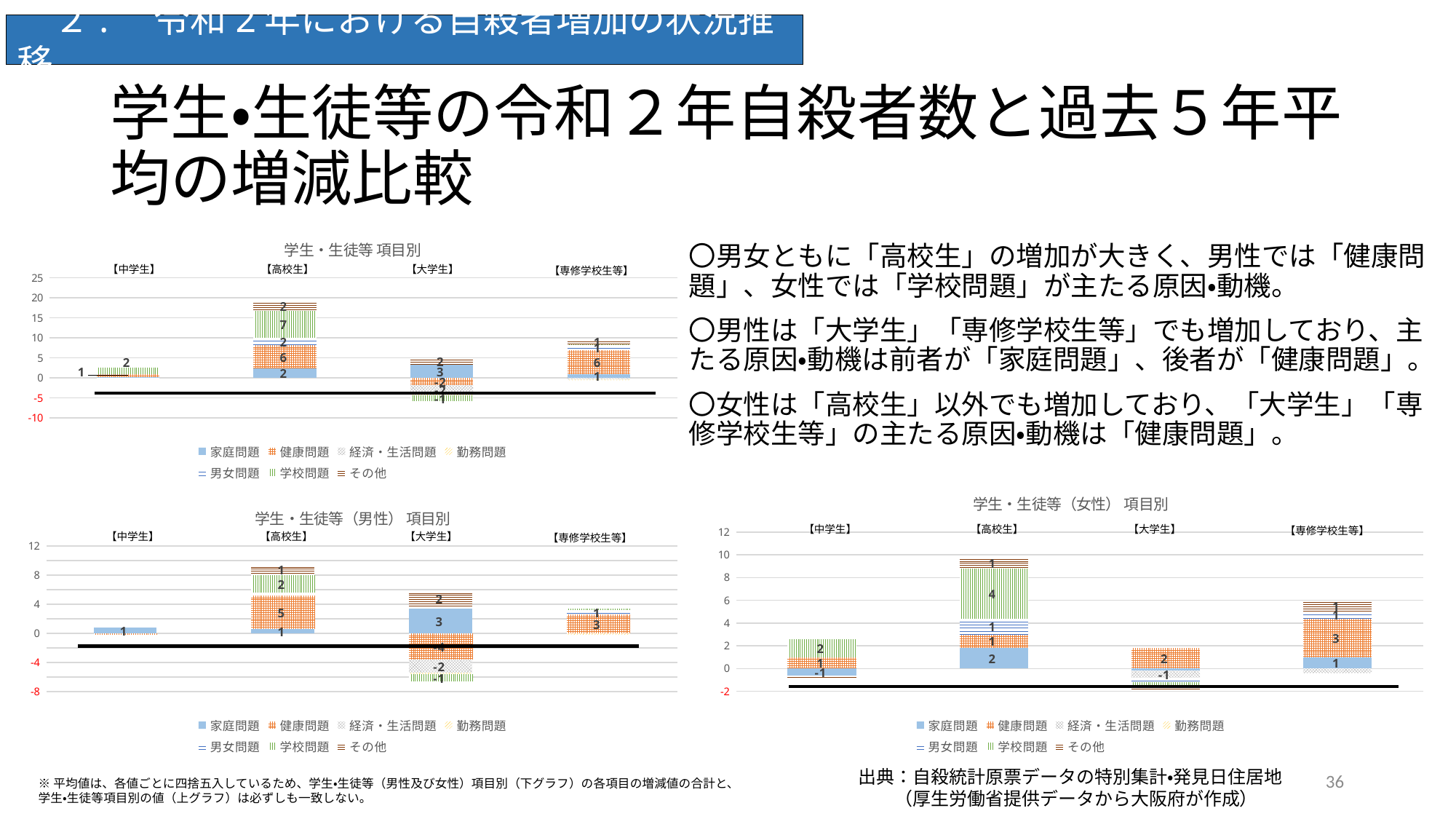
In the bottom-right chart 学生・生徒等（女性） 項目別, which category has the tallest stacked bar? 高校生 In the bottom-left chart 学生・生徒等（男性） 項目別, what is the value of 健康問題 for 高校生? 5 In the top-left chart 学生・生徒等 項目別, how many series does the legend list? 7 In the top-left chart 学生・生徒等 項目別, which category has the tallest stacked bar? 高校生 In the bottom-left chart 学生・生徒等（男性） 項目別, what is the value of 家庭問題 for 大学生? 3 In the top-left chart 学生・生徒等 項目別, what is the value of 学校問題 for 高校生? 7 In the bottom-right chart 学生・生徒等（女性） 項目別, what is the value of 学校問題 for 高校生? 4 In the top-left chart 学生・生徒等 項目別, how many student categories are shown on the x axis? 4 In the top-left chart 学生・生徒等 項目別, is the top of the stacked bar for 高校生 greater or less than 15? greater What kind of chart is the top-left chart titled 学生・生徒等 項目別? stacked bar chart In the bottom-right chart 学生・生徒等（女性） 項目別, what is the value of 健康問題 for 専修学校生等? 3 What is the title of the bottom-right chart? 学生・生徒等（女性） 項目別